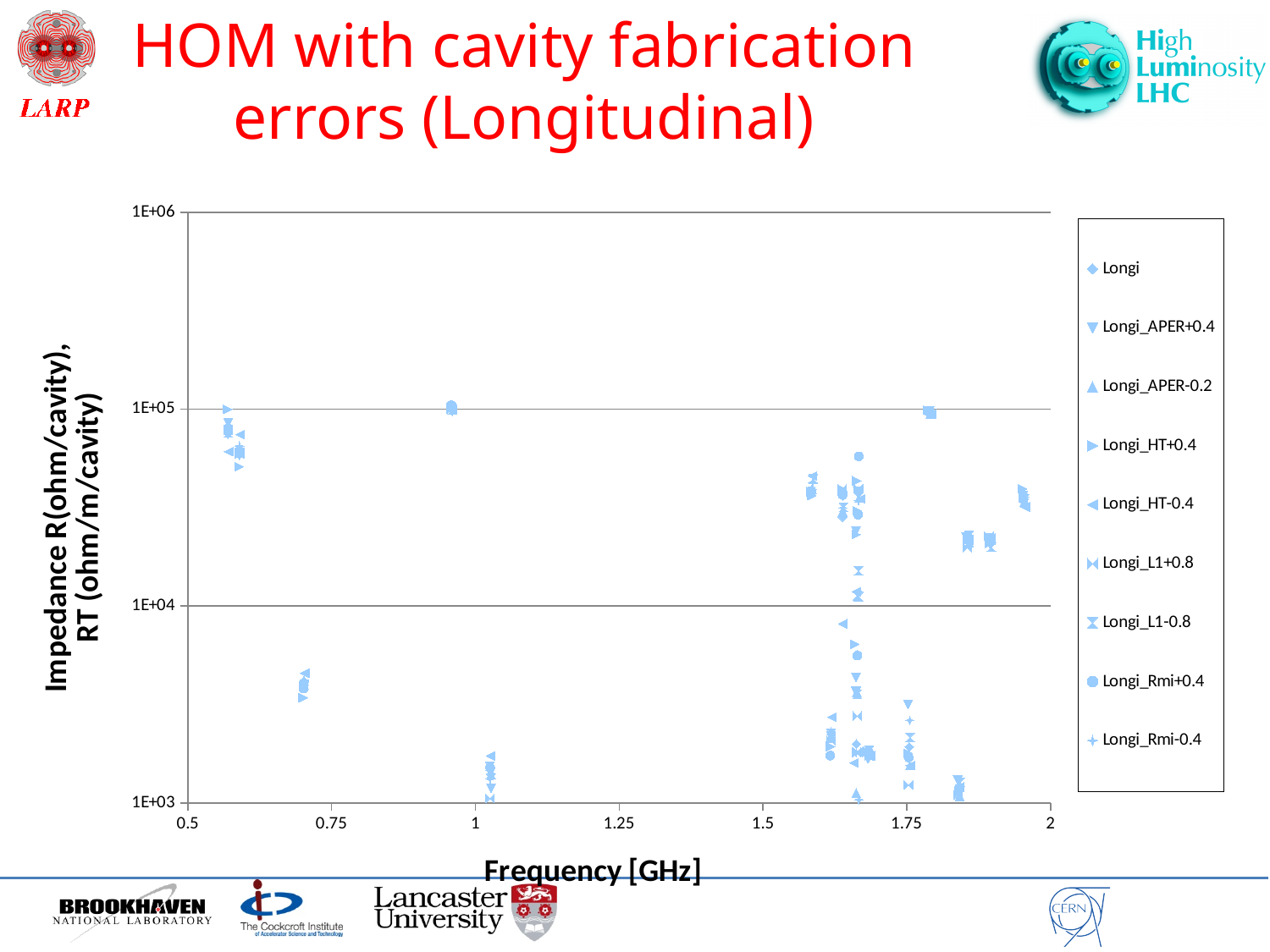
What is the title of the x axis? Frequency [GHz] Are the points plotted near 0.7 GHz greater or less than 1E+04? less Are the points plotted near 1.95 GHz greater or less than 1E+04? greater Are the points plotted near 1.95 GHz greater or less than 1E+05? less What is the largest value shown on the x axis? 2 What kind of chart is shown on the slide? scatter chart How many series does the legend list? 9 What is the first series listed in the legend? Longi